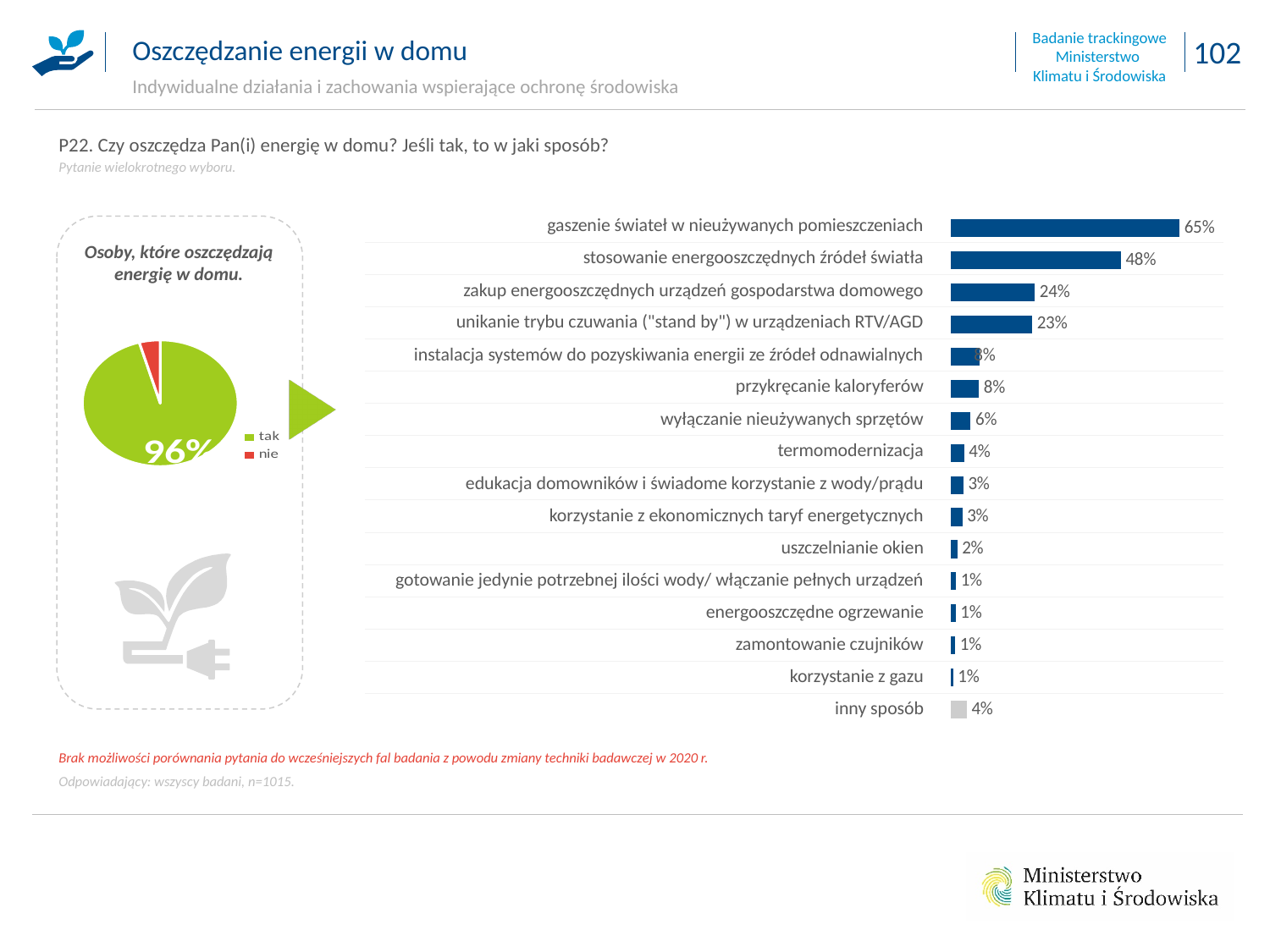
How many entries does the legend of the pie chart list? 2 On the bar chart, what is the value for "inny sposób"? 4% On the bar chart, what is the difference between "zakup energooszczędnych urządzeń gospodarstwa domowego" and "przykręcanie kaloryferów"? 16 percentage points On the bar chart, what is the value for "gaszenie świateł w nieużywanych pomieszczeniach"? 65% On the bar chart, which is larger: "przykręcanie kaloryferów" or "wyłączanie nieużywanych sprzętów"? przykręcanie kaloryferów On the bar chart, what is the value for "stosowanie energooszczędnych źródeł światła"? 48% What type of chart is the chart on the right side of the slide? bar chart On the pie chart on the left, what share is labelled for "tak"? 96% How many categories does the bar chart show? 16 On the bar chart, what is the value for "unikanie trybu czuwania ("stand by") w urządzeniach RTV/AGD"? 23% On the bar chart, what is the difference between "gaszenie świateł w nieużywanych pomieszczeniach" and "stosowanie energooszczędnych źródeł światła"? 17 percentage points On the bar chart, which category has the highest value? gaszenie świateł w nieużywanych pomieszczeniach